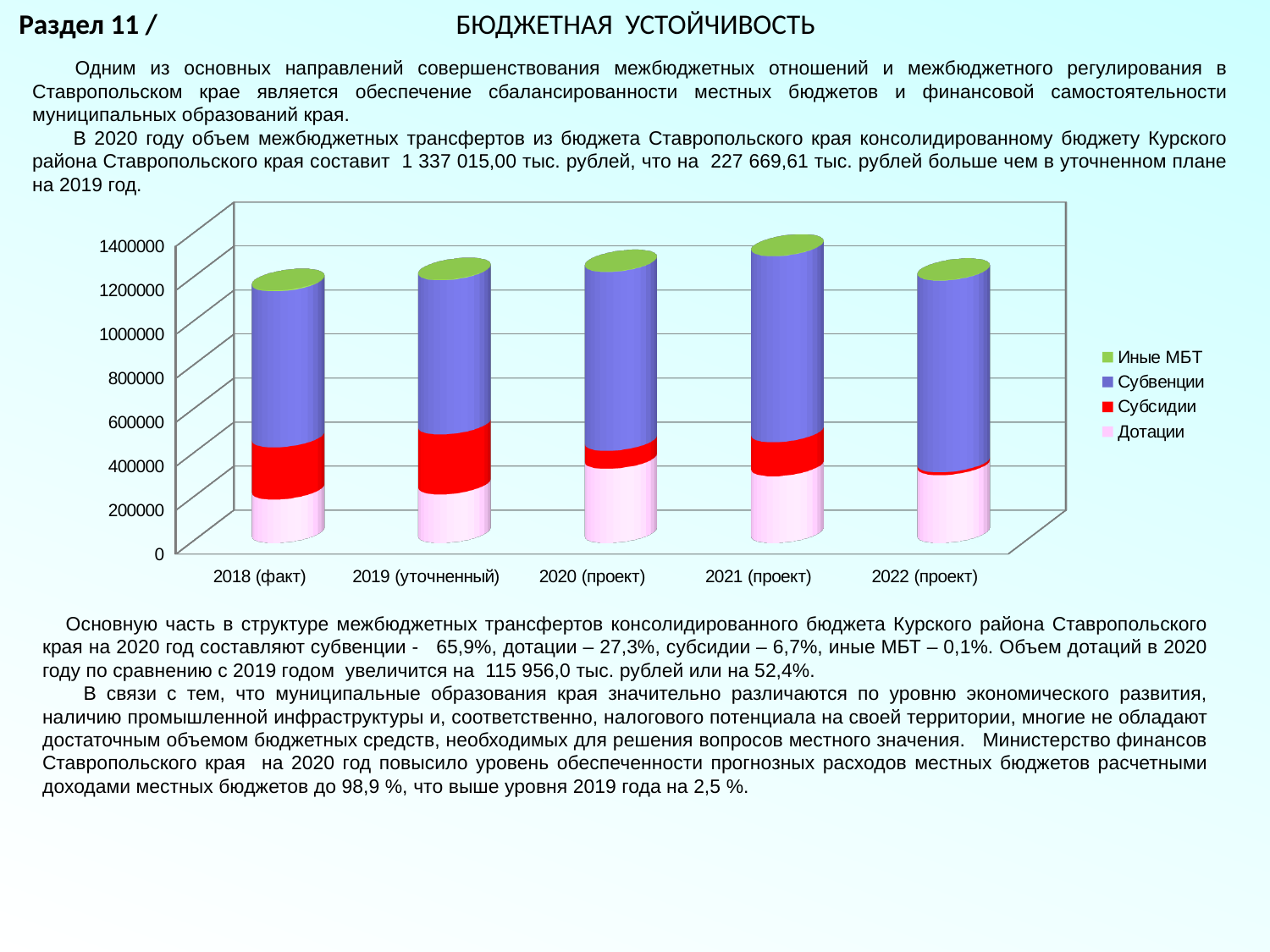
Which series is shown at the bottom of each stacked bar? Дотации What colour represents the Субвенции series in the chart? Blue-purple What kind of chart is shown on the slide? Stacked bar chart Which is larger, the Субсидии segment in 2019 (уточненный) or in 2022 (проект)? 2019 (уточненный) Is the total for 2021 (проект) greater or less than 1200000? greater What is the label of the first category on the x axis? 2018 (факт) Which year has the tallest stacked bar in the chart? 2021 (проект) How many categories (years) are shown on the x axis of the chart? 5 Is the total for 2018 (факт) greater or less than 1000000? greater How many series does the chart legend list? 4 Which is larger, the total stacked bar for 2021 (проект) or for 2018 (факт)? 2021 (проект) Do the stacked bar totals rise or fall from 2018 (факт) to 2021 (проект)? rise